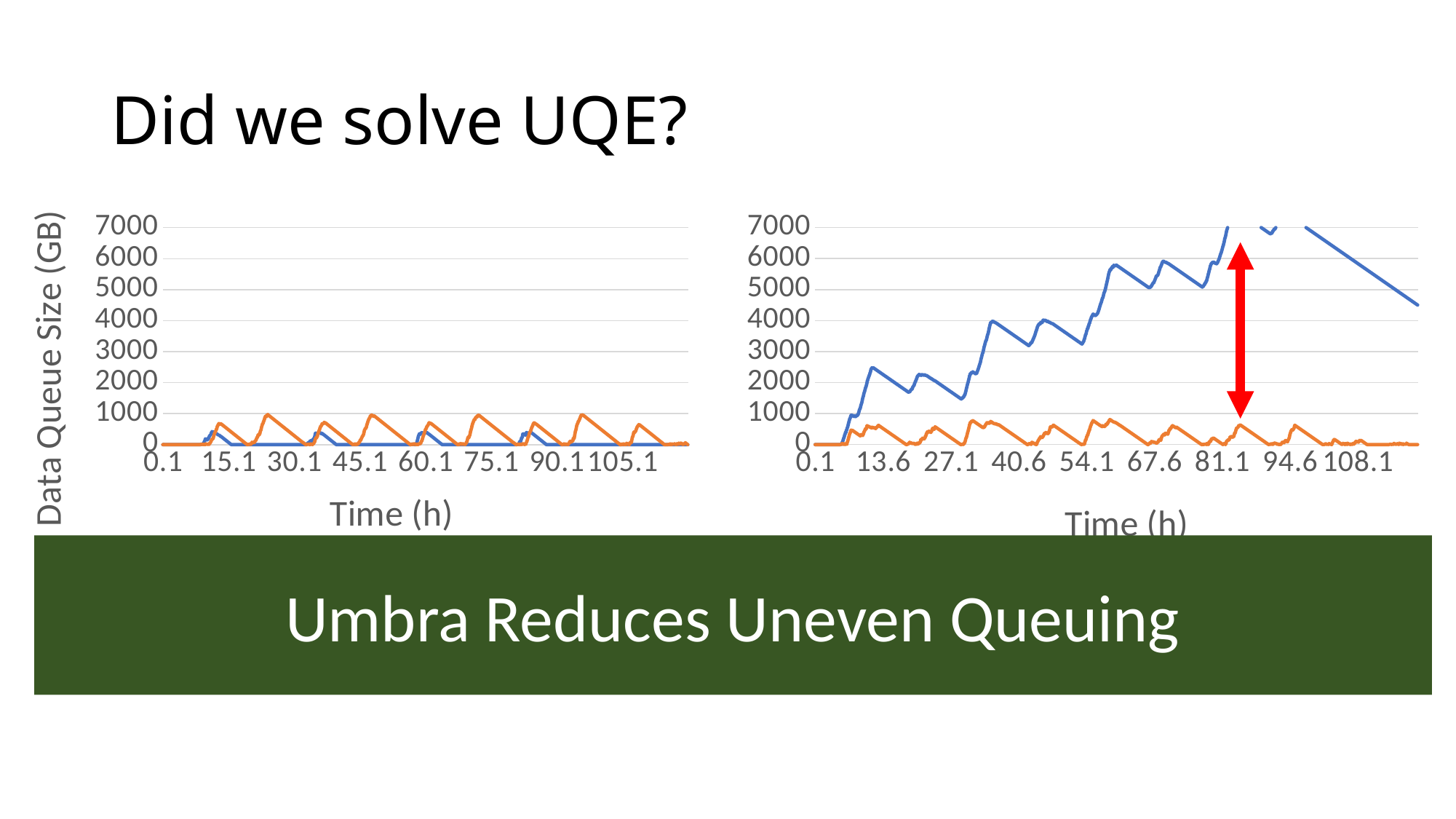
On the left chart, what is the label of the y axis? Data Queue Size (GB) What is the highest value shown on the y axis of the right chart? 7000 On the right chart, is the highest value reached by the orange line greater or less than 2000? less On the left chart, is the highest value reached by the blue line greater or less than 2000? less How many lines are plotted on the left chart? 2 On the right chart, is the value of the blue line at 81.1 hours greater or less than 5000? greater What kind of chart is the chart on the left of the slide? line chart What kind of chart is the chart on the right of the slide? line chart On the right chart, what is the label of the x axis? Time (h) On the right chart, does the blue line generally rise or fall between 0.1 and 81.1 hours? rise On the right chart, which line reaches higher values, the blue line or the orange line? the blue line